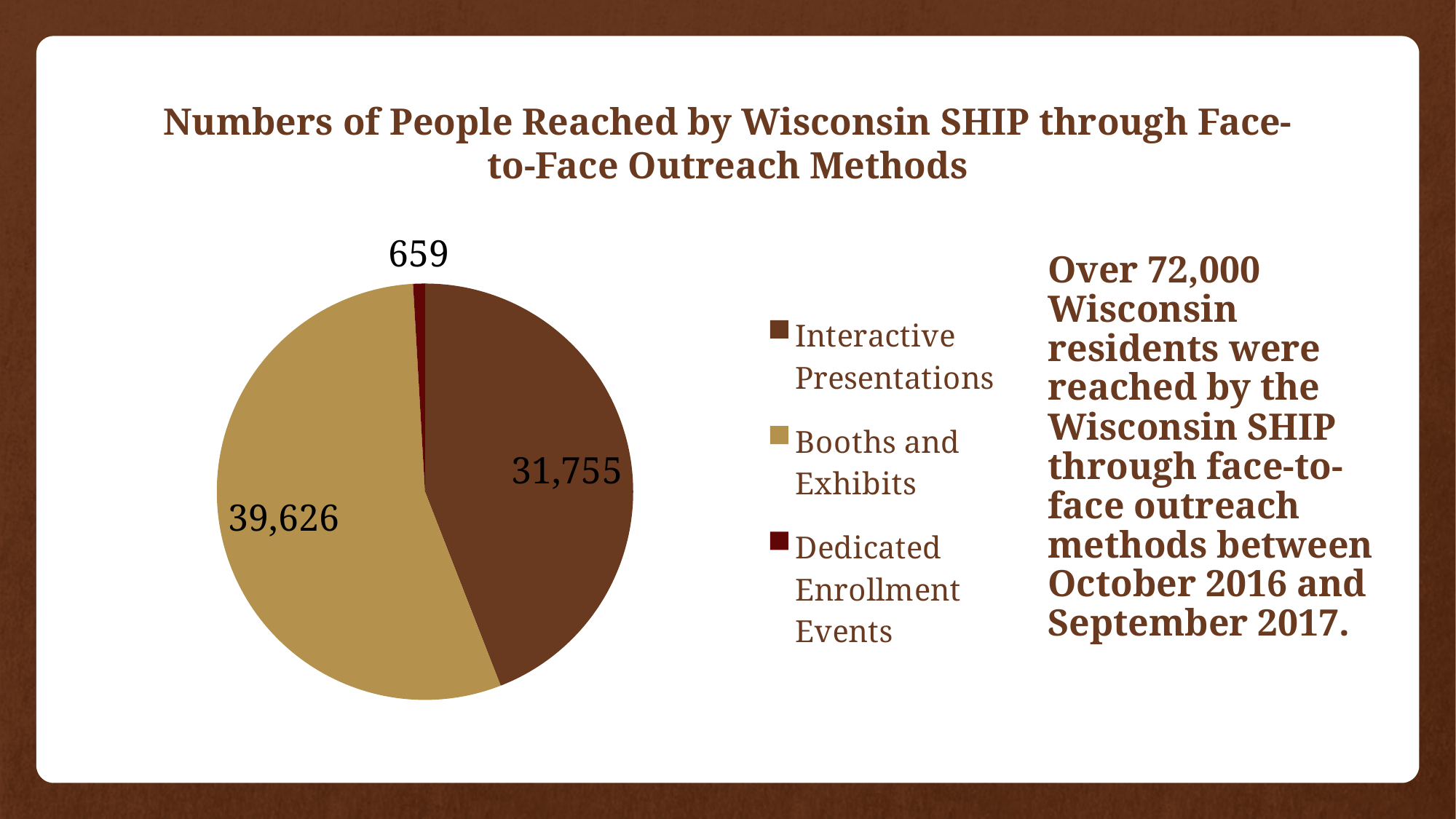
How many more people were reached through Booths and Exhibits than through Interactive Presentations? 7,871 What type of chart is shown on the slide? Pie chart How many slices does the pie chart have? 3 Which outreach method reached the fewest people? Dedicated Enrollment Events What is the total number of people reached across all three outreach methods shown in the pie chart? 72,040 Which outreach method reached the most people? Booths and Exhibits How many people were reached through Booths and Exhibits? 39,626 What colour is the slice for Dedicated Enrollment Events? Dark red How many more people were reached through Interactive Presentations than through Dedicated Enrollment Events? 31,096 Which reached more people, Interactive Presentations or Booths and Exhibits? Booths and Exhibits How many people were reached through Dedicated Enrollment Events? 659 How many people were reached through Interactive Presentations? 31,755